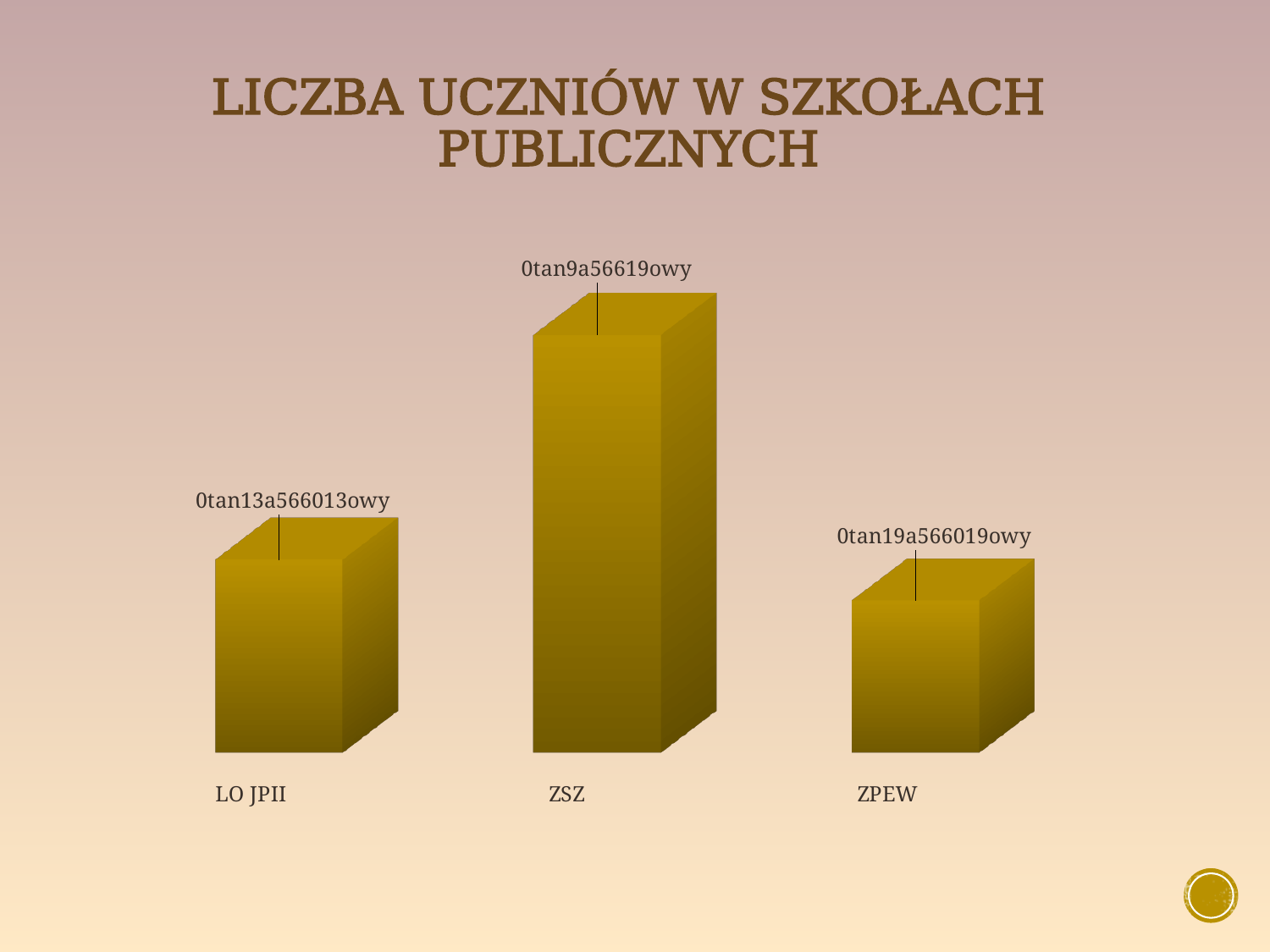
Which has the larger value, ZSZ or LO JPII? ZSZ What is the title of the chart on the slide? LICZBA UCZNIÓW W SZKOŁACH PUBLICZNYCH Which category has the highest bar in the chart? ZSZ What kind of chart is shown on the slide? bar chart Which has the larger value, LO JPII or ZPEW? LO JPII Which category is plotted in the middle position of the chart? ZSZ Does the value rise or fall from ZSZ to ZPEW? fall Which category has the lowest bar in the chart? ZPEW How many categories are plotted in the chart? 3 Does the value rise or fall from LO JPII to ZSZ? rise